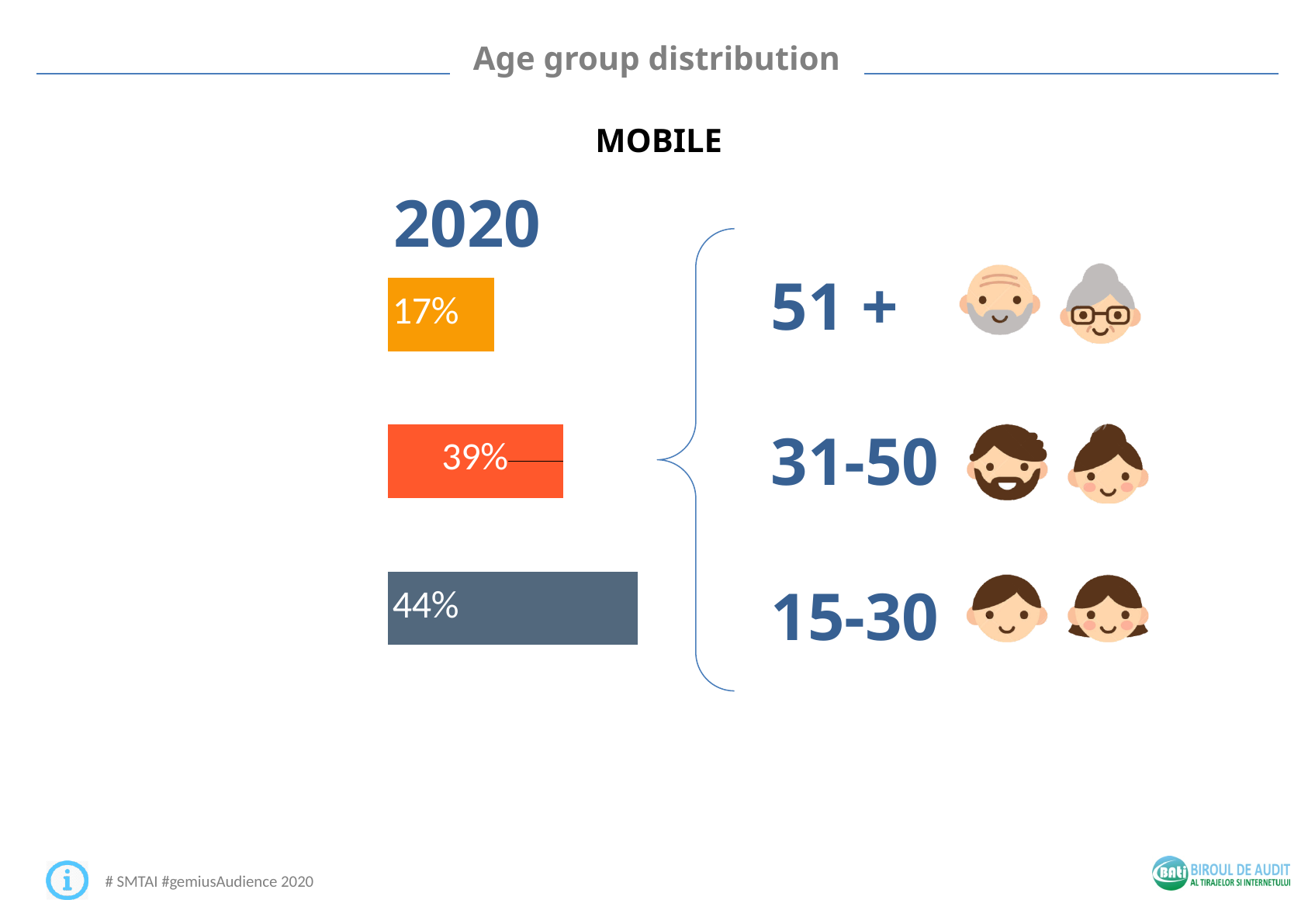
Which age group has the lowest share? 51 + How many age groups are shown in the chart? 3 Which age group has the highest share? 15-30 Which year does the chart show data for? 2020 What is the value for the 51 + age group? 17% What is the value for the 15-30 age group? 44% What is the difference between the 15-30 and 51 + age groups? 27% What is the difference between the 31-50 and 15-30 age groups? 5% Which is larger, the value for 31-50 or the value for 51 +? 31-50 What kind of chart is shown on the slide? bar chart What is the value for the 31-50 age group? 39% What is the title of the slide? Age group distribution